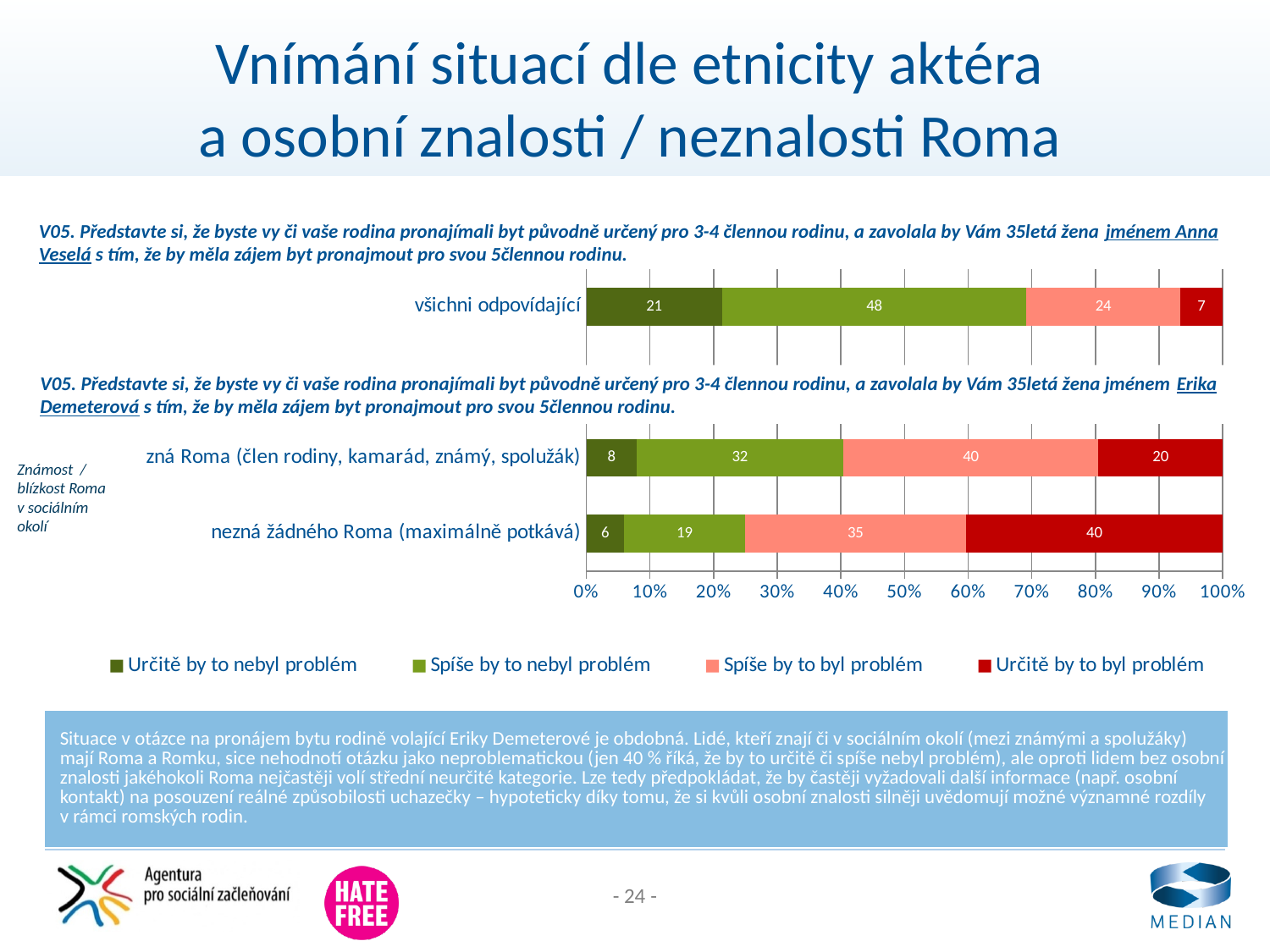
What kind of chart is shown on the slide? stacked bar chart What is the difference between the "Spíše by to nebyl problém" values for "všichni odpovídající" and "nezná žádného Roma (maximálně potkává)"? 29 Which category has the highest value for "Určitě by to byl problém"? nezná žádného Roma (maximálně potkává) What is the value of "Určitě by to byl problém" for "nezná žádného Roma (maximálně potkává)"? 40 What is the value of "Určitě by to nebyl problém" for "všichni odpovídající"? 21 What is the value of "Spíše by to byl problém" for "všichni odpovídající"? 24 How many categories (bars) does the chart show? 3 Which category has the lowest value for "Určitě by to nebyl problém"? nezná žádného Roma (maximálně potkává) How many series does the legend list? 4 Which is larger: "Spíše by to byl problém" for "zná Roma (člen rodiny, kamarád, známý, spolužák)" or for "nezná žádného Roma (maximálně potkává)"? zná Roma (člen rodiny, kamarád, známý, spolužák) What is the total of the stacked bar for "zná Roma (člen rodiny, kamarád, známý, spolužák)"? 100 What is the value of "Spíše by to nebyl problém" for "zná Roma (člen rodiny, kamarád, známý, spolužák)"? 32